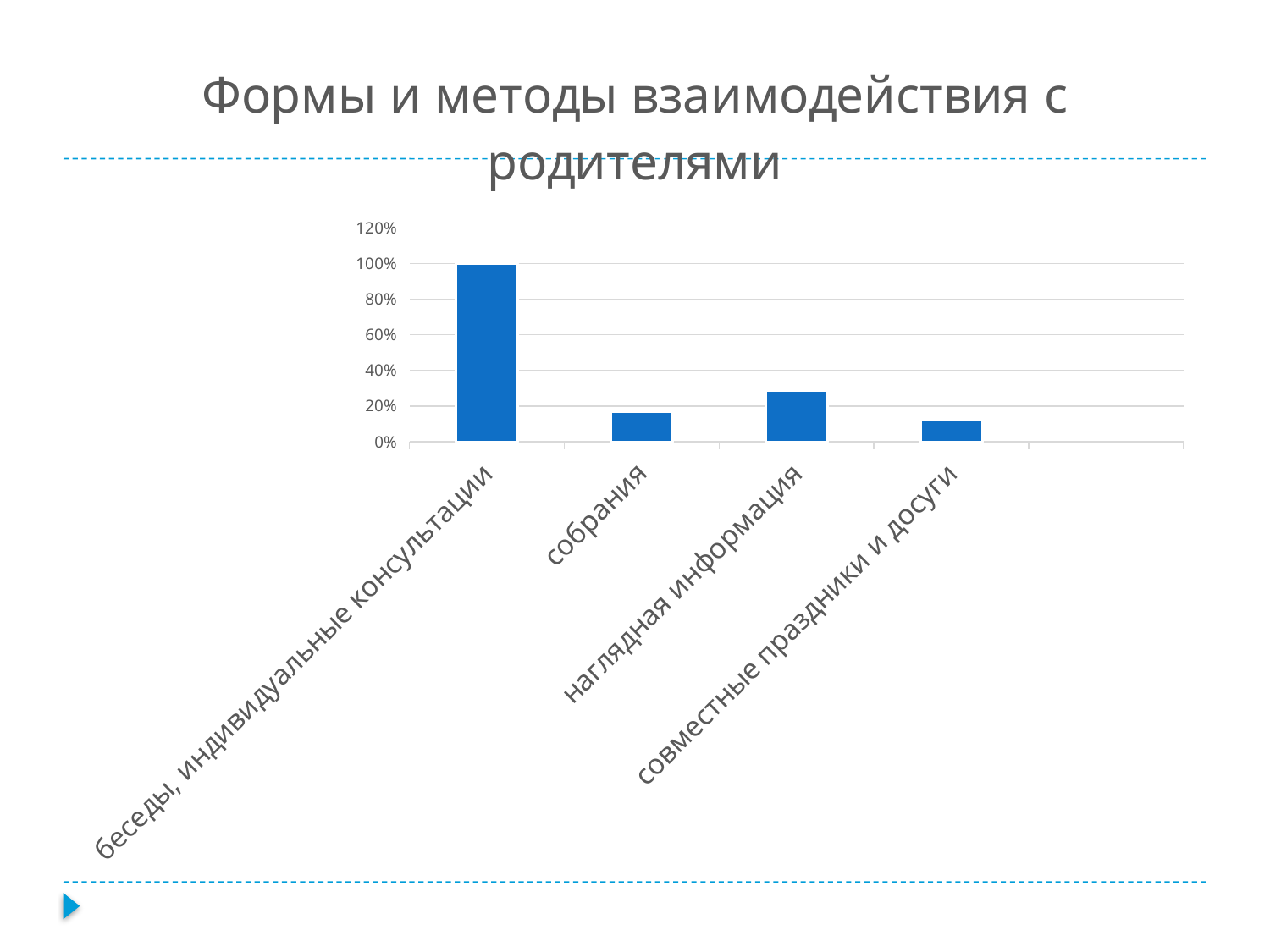
Which is larger, the value for собрания or the value for наглядная информация? наглядная информация What is the highest value shown on the vertical axis of the chart? 120% What is the title of the slide containing the chart? Формы и методы взаимодействия с родителями How many categories are shown on the x axis of the chart? 4 Is the value for совместные праздники и досуги greater or less than 20%? less Which category has the highest value in the chart? беседы, индивидуальные консультации Which category has the lowest value in the chart? совместные праздники и досуги Is the value for беседы, индивидуальные консультации greater or less than 80%? greater Which is larger, the value for беседы, индивидуальные консультации or the value for наглядная информация? беседы, индивидуальные консультации What kind of chart is shown on the slide? bar chart Is the value for собрания greater or less than 20%? less